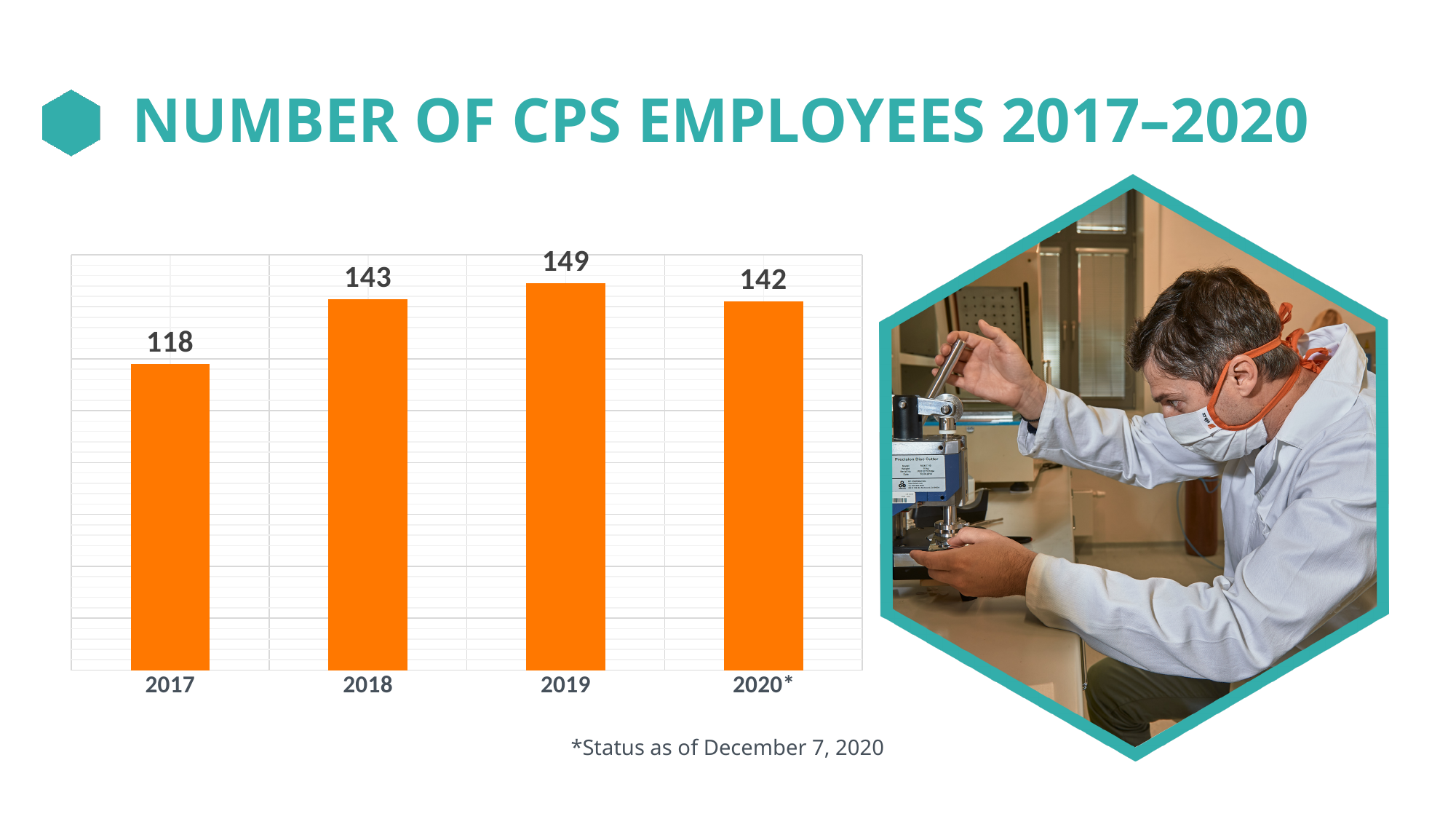
What type of chart is shown on the slide? Bar chart What was the number of CPS employees in 2017? 118 Did the number of employees rise or fall from 2019 to 2020*? Fall Which year had the highest number of CPS employees? 2019 Which year had the lowest number of CPS employees? 2017 By how much did the number of employees increase from 2017 to 2018? 25 What was the number of CPS employees in 2019? 149 What is the difference between the 2019 and 2020* values? 7 How many years are shown on the chart? 4 What is the title of the chart on the slide? NUMBER OF CPS EMPLOYEES 2017–2020 What value is shown for 2020*? 142 Which year had more employees, 2018 or 2020*? 2018